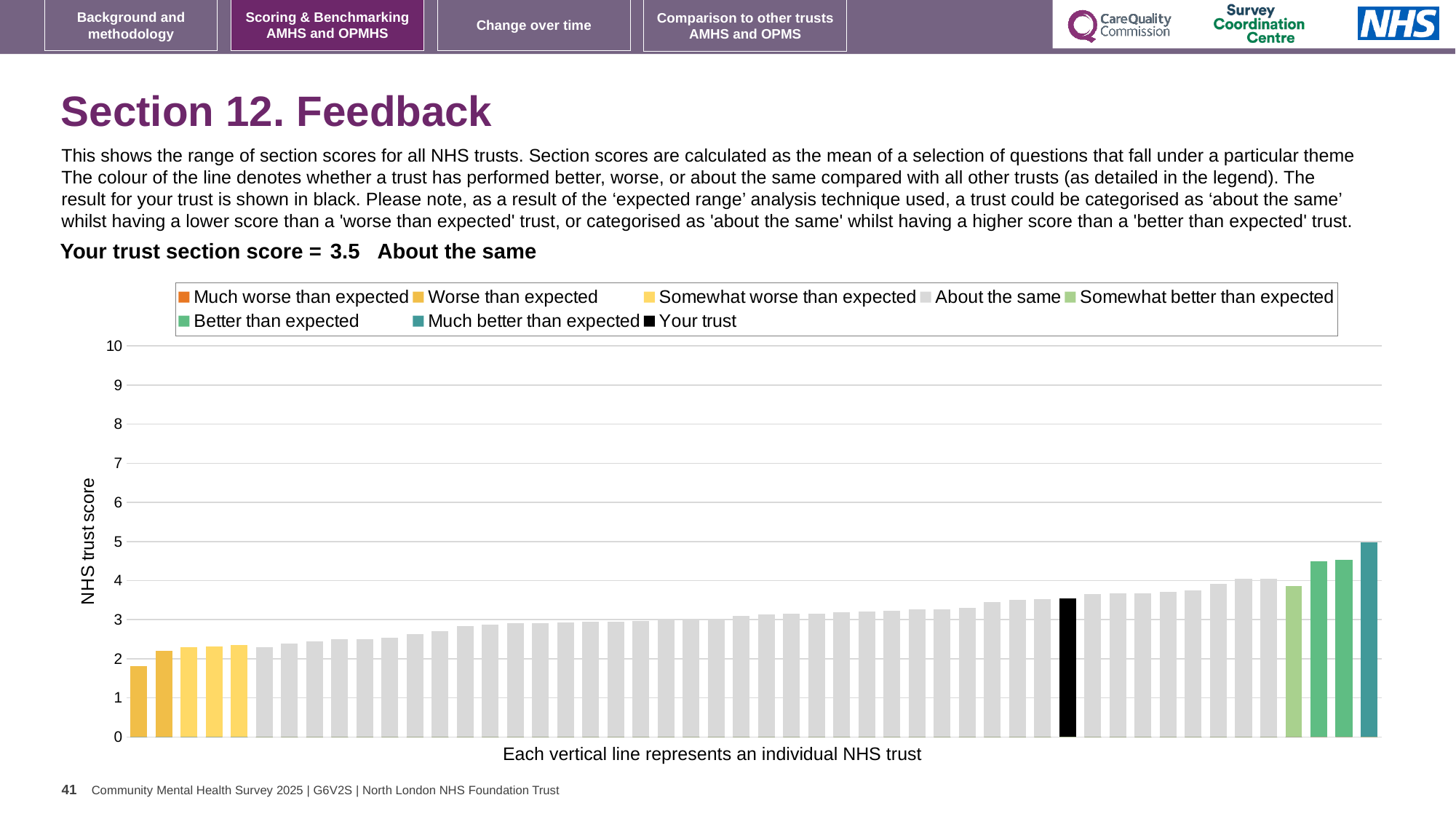
Is the value of the tallest bar (the 'Much better than expected' trust) greater or less than 4? greater Which legend entry is represented by the black bar? Your trust What is the highest value shown on the vertical axis? 10 How many entries does the chart legend list? 8 What is the label on the vertical axis of the chart? NHS trust score What is the section score for your trust shown on the slide? 3.5 Which category is your trust's section score placed in? About the same What kind of chart is shown on the slide? bar chart Is the value of the black 'Your trust' bar greater or less than 3? greater How many bars are coloured as 'Much better than expected' (teal)? 1 Do the bar values rise or fall from left to right along the x axis? rise Is the value of the leftmost (lowest) bar greater or less than 2? less